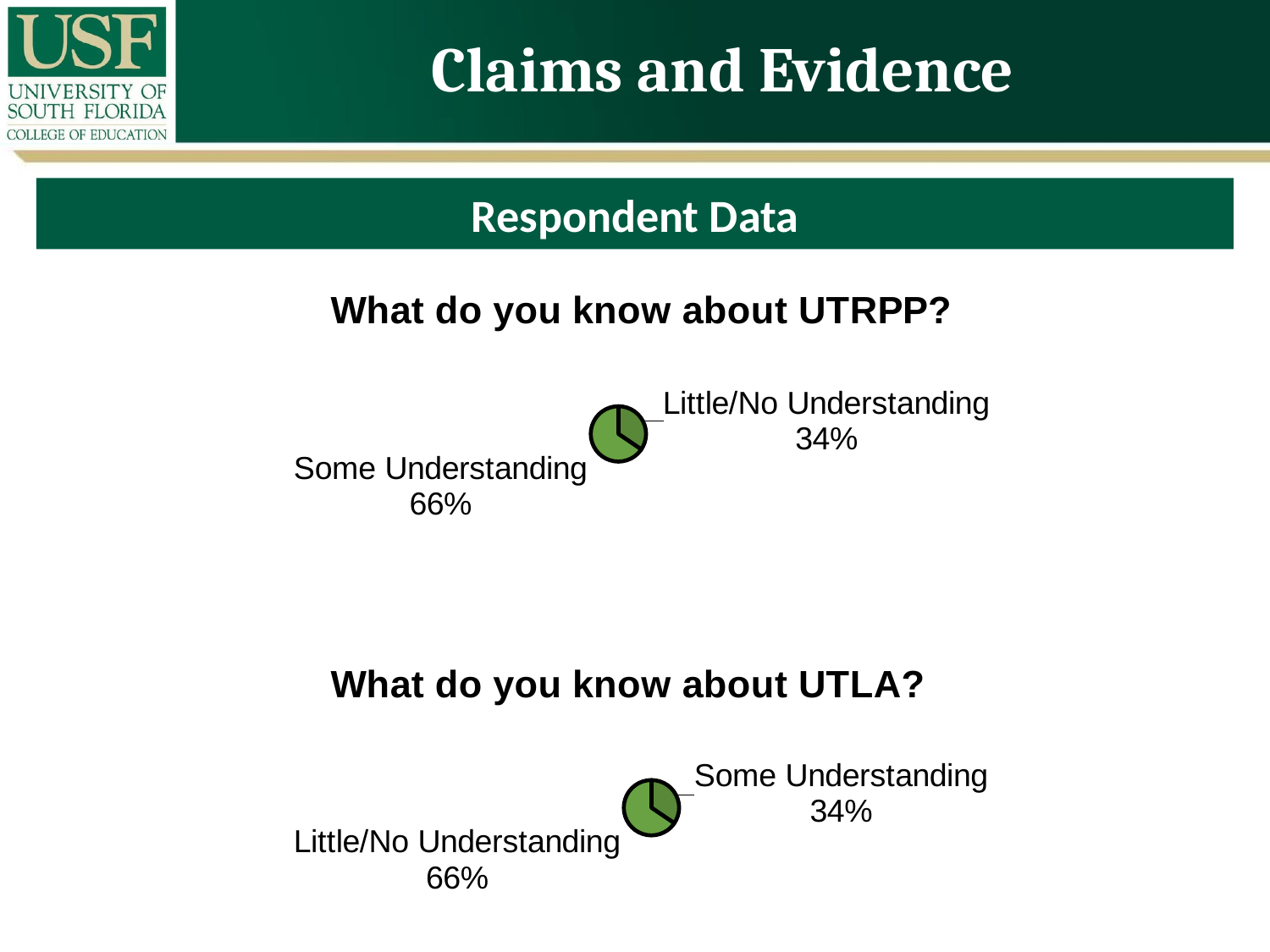
In the 'What do you know about UTLA?' chart, which category has the largest slice? Little/No Understanding How many categories does the 'What do you know about UTRPP?' chart show? 2 In the 'What do you know about UTRPP?' chart, which category has the largest slice? Some Understanding In the 'What do you know about UTLA?' chart, which category has the smallest slice? Some Understanding In the 'What do you know about UTRPP?' chart, what share of respondents reported Little/No Understanding? 34% In the 'What do you know about UTLA?' chart, what share of respondents reported Some Understanding? 34% In the 'What do you know about UTRPP?' chart, what is the difference in percentage points between Some Understanding and Little/No Understanding? 32 How many charts are shown on the slide? 2 In the 'What do you know about UTLA?' chart, what share of respondents reported Little/No Understanding? 66% What type of chart is used for 'What do you know about UTLA?'? Pie chart In the 'What do you know about UTRPP?' chart, what share of respondents reported Some Understanding? 66% In the 'What do you know about UTRPP?' chart, which category has the smallest slice? Little/No Understanding